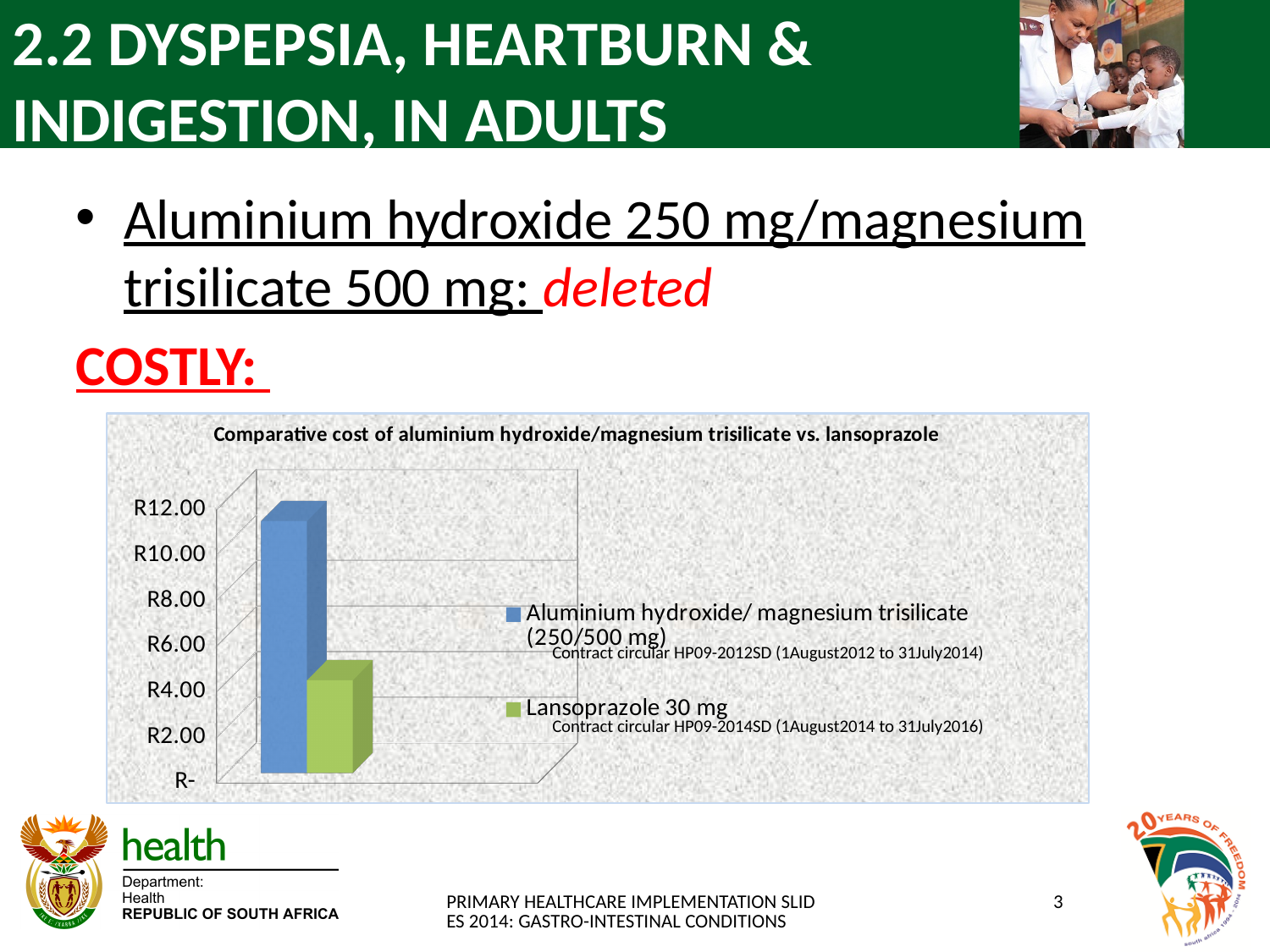
Is the cost of Lansoprazole 30 mg greater or less than R6.00? less Is the cost of Lansoprazole 30 mg greater or less than R2.00? greater Is the cost of Aluminium hydroxide/ magnesium trisilicate (250/500 mg) greater or less than R8.00? greater Which series has the lower cost in the chart? Lansoprazole 30 mg Which series has the higher cost in the chart? Aluminium hydroxide/ magnesium trisilicate (250/500 mg) How many series does the chart legend list? 2 What is the title of the chart? Comparative cost of aluminium hydroxide/magnesium trisilicate vs. lansoprazole How many bars are plotted in the chart? 2 Which is larger: the cost of Aluminium hydroxide/ magnesium trisilicate (250/500 mg) or the cost of Lansoprazole 30 mg? Aluminium hydroxide/ magnesium trisilicate (250/500 mg) What kind of chart is shown on the slide? bar chart What colour represents Lansoprazole 30 mg in the chart? green